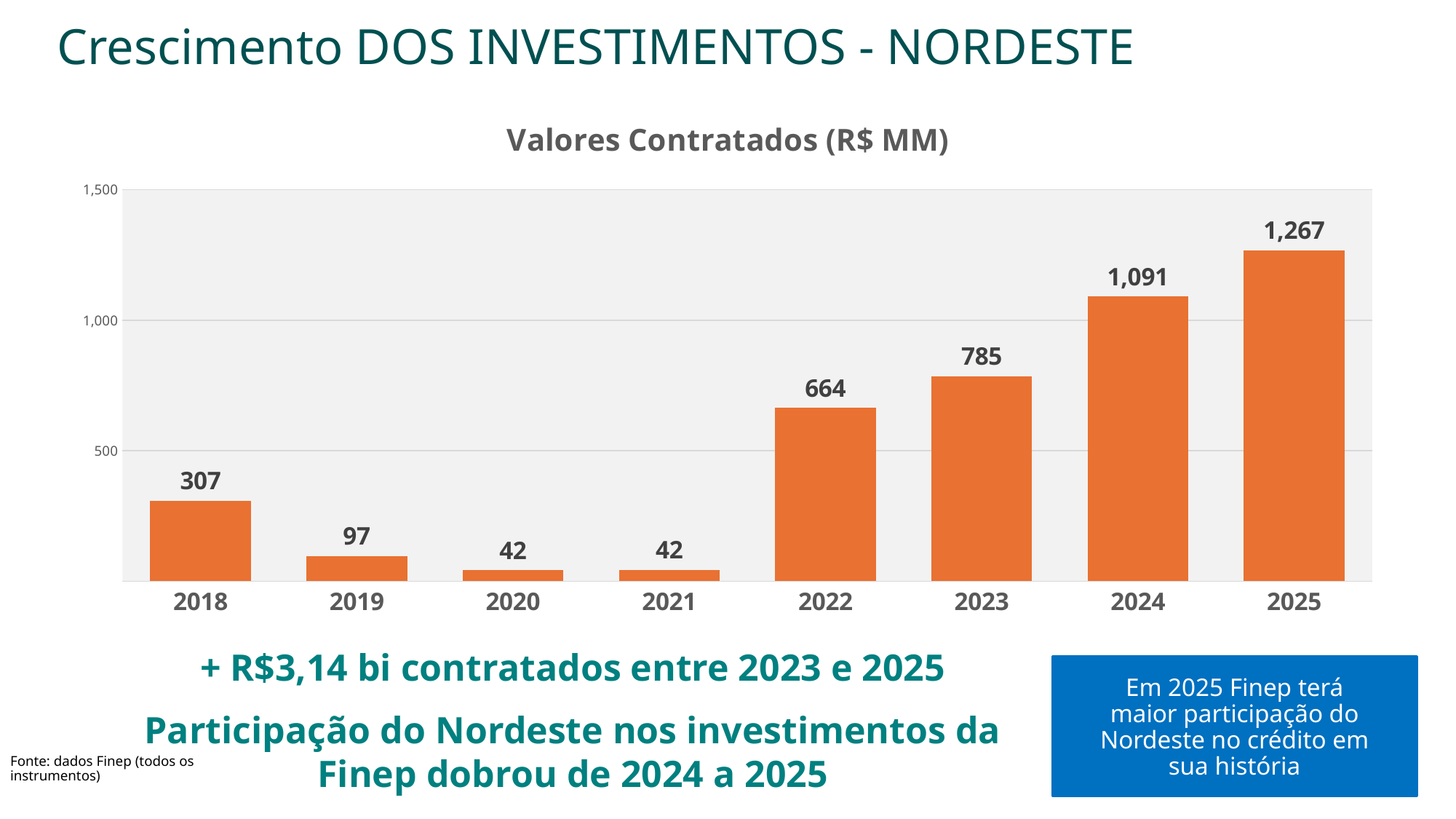
Do the values in the Valores Contratados (R$ MM) chart rise or fall from 2021 to 2025? rise What is the difference between the values for 2023 and 2022 in the Valores Contratados (R$ MM) chart? 121 What kind of chart is the Valores Contratados (R$ MM) chart? bar chart What is the lowest value shown in the Valores Contratados (R$ MM) chart? 42 What is the difference between the values for 2025 and 2024 in the Valores Contratados (R$ MM) chart? 176 How many years are shown on the x axis of the Valores Contratados (R$ MM) chart? 8 What is the value for 2018 in the Valores Contratados (R$ MM) chart? 307 Which is larger in the Valores Contratados (R$ MM) chart, the value for 2018 or the value for 2019? 2018 What is the value for 2025 in the Valores Contratados (R$ MM) chart? 1,267 What is the value for 2022 in the Valores Contratados (R$ MM) chart? 664 Is the value for 2024 in the Valores Contratados (R$ MM) chart greater or less than 1,000? greater Which year has the highest value in the Valores Contratados (R$ MM) chart? 2025